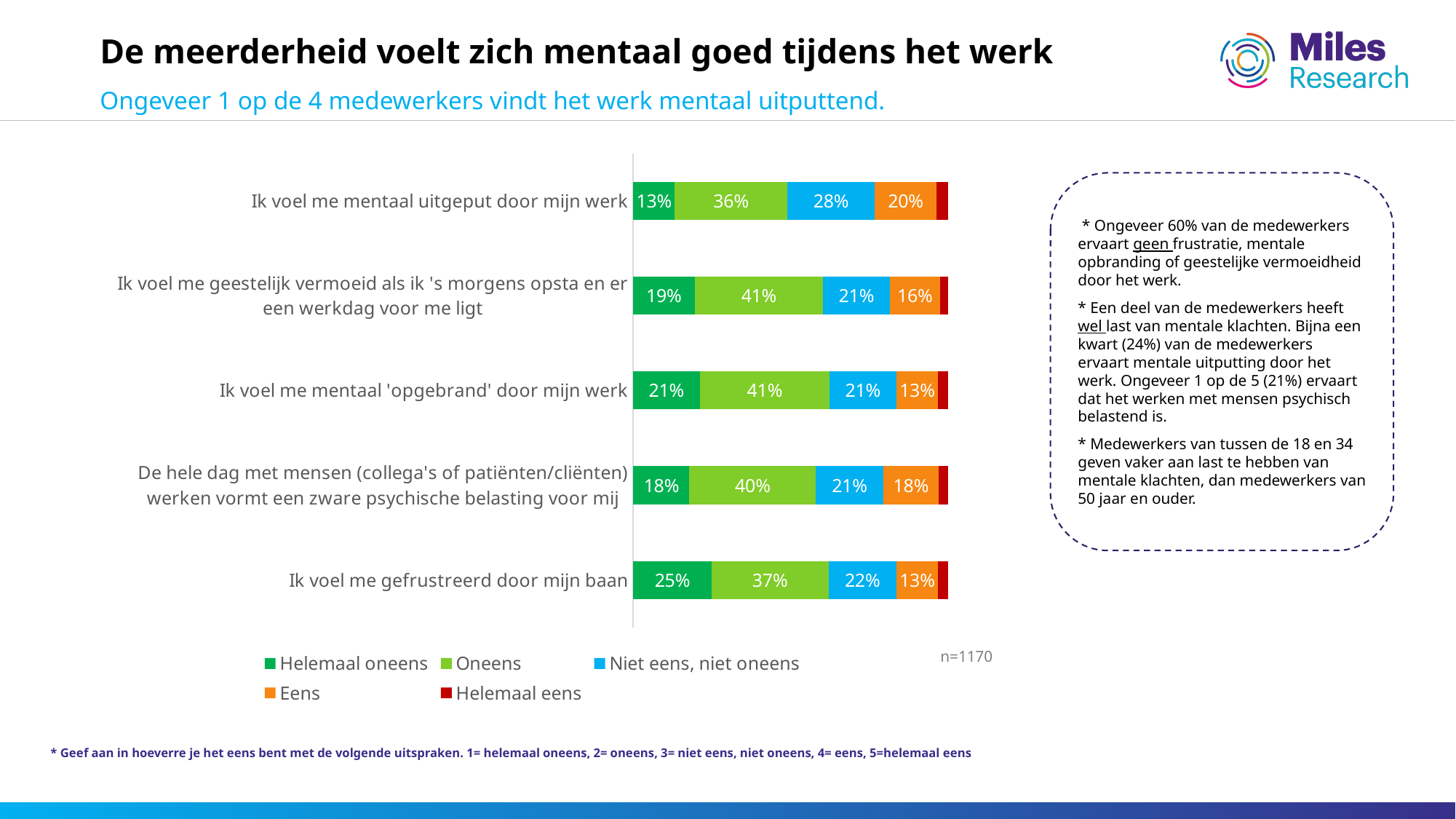
What kind of chart is shown on the slide? Stacked bar chart What percentage answered 'Helemaal oneens' for 'Ik voel me gefrustreerd door mijn baan'? 25% Which statement has the lowest 'Helemaal oneens' percentage? Ik voel me mentaal uitgeput door mijn werk How many statements (categories) are plotted in the chart? 5 What is the difference between the 'Eens' percentages for 'Ik voel me mentaal uitgeput door mijn werk' and 'Ik voel me mentaal 'opgebrand' door mijn werk'? 7% What percentage answered 'Niet eens, niet oneens' for 'Ik voel me mentaal uitgeput door mijn werk'? 28% What percentage answered 'Eens' for 'Ik voel me geestelijk vermoeid als ik 's morgens opsta en er een werkdag voor me ligt'? 16% Which is larger: the 'Oneens' percentage for 'Ik voel me gefrustreerd door mijn baan' or for 'De hele dag met mensen (collega's of patiënten/cliënten) werken vormt een zware psychische belasting voor mij'? De hele dag met mensen (collega's of patiënten/cliënten) werken vormt een zware psychische belasting voor mij How many series does the legend list? 5 What percentage answered 'Oneens' for 'Ik voel me mentaal uitgeput door mijn werk'? 36% What sample size (n) is shown next to the chart? n=1170 Which statement has the highest 'Helemaal oneens' percentage? Ik voel me gefrustreerd door mijn baan